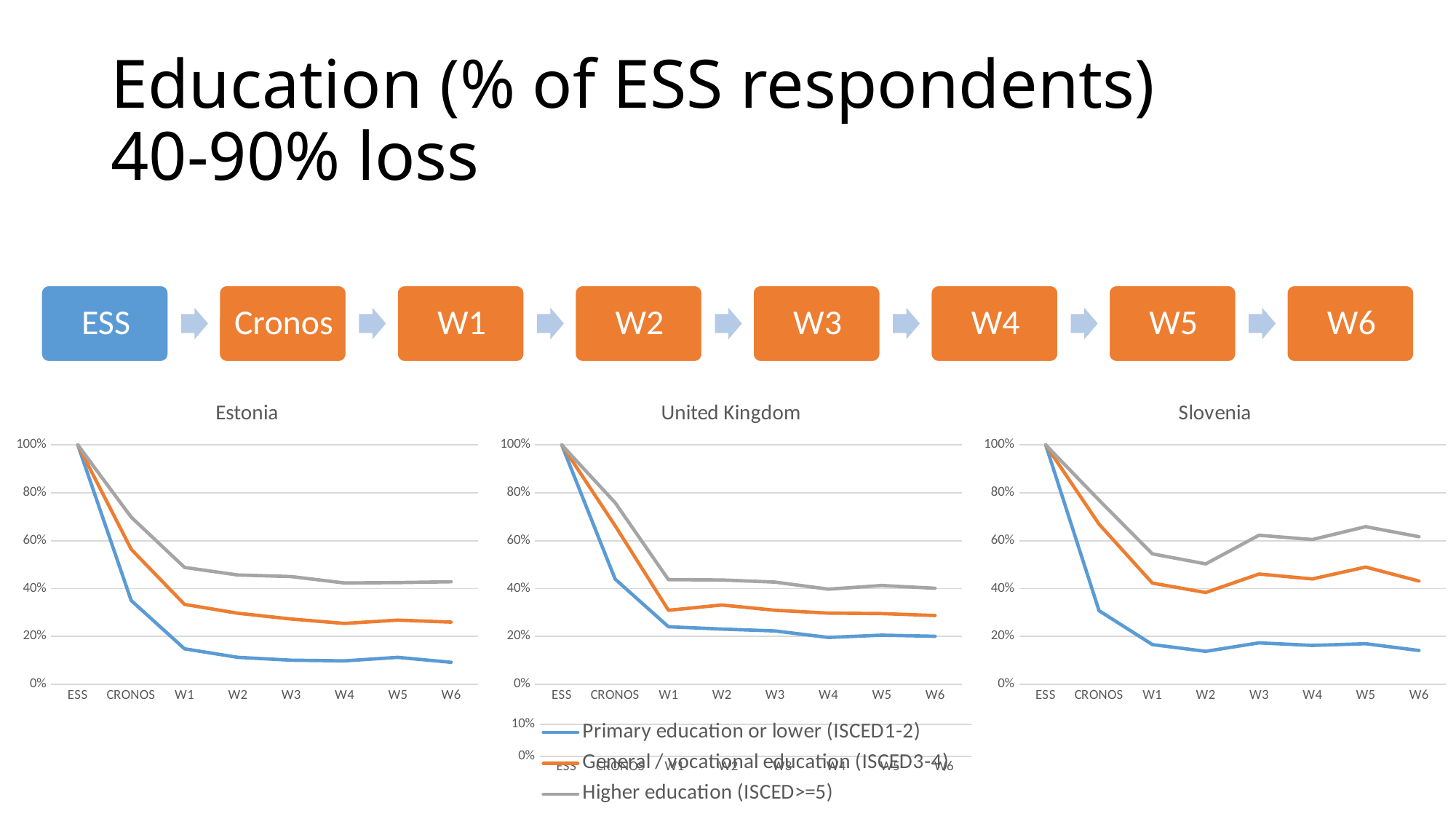
At W5, is the value for Higher education (ISCED>=5) larger in the Slovenia chart or in the Estonia chart? Slovenia What is the title of the middle chart on the slide? United Kingdom In the Estonia chart, which series has the lowest value at W6? Primary education or lower (ISCED1-2) In the United Kingdom chart, is the value for General / vocational education (ISCED3-4) at W6 greater or less than 40%? less In the Estonia chart, is the value for Primary education or lower (ISCED1-2) at W6 greater or less than 20%? less How many series does the legend list for the charts? 3 What kind of chart is the Estonia chart? line chart In the Slovenia chart, which series has the highest value at W6? Higher education (ISCED>=5) How many points are on the x axis of the United Kingdom chart? 8 In the Estonia chart, what is the value for Higher education (ISCED>=5) at ESS? 100% In the Slovenia chart, do the values for Primary education or lower (ISCED1-2) rise or fall from ESS to W1? fall In the Slovenia chart, is the value for Higher education (ISCED>=5) at W5 greater or less than 60%? greater